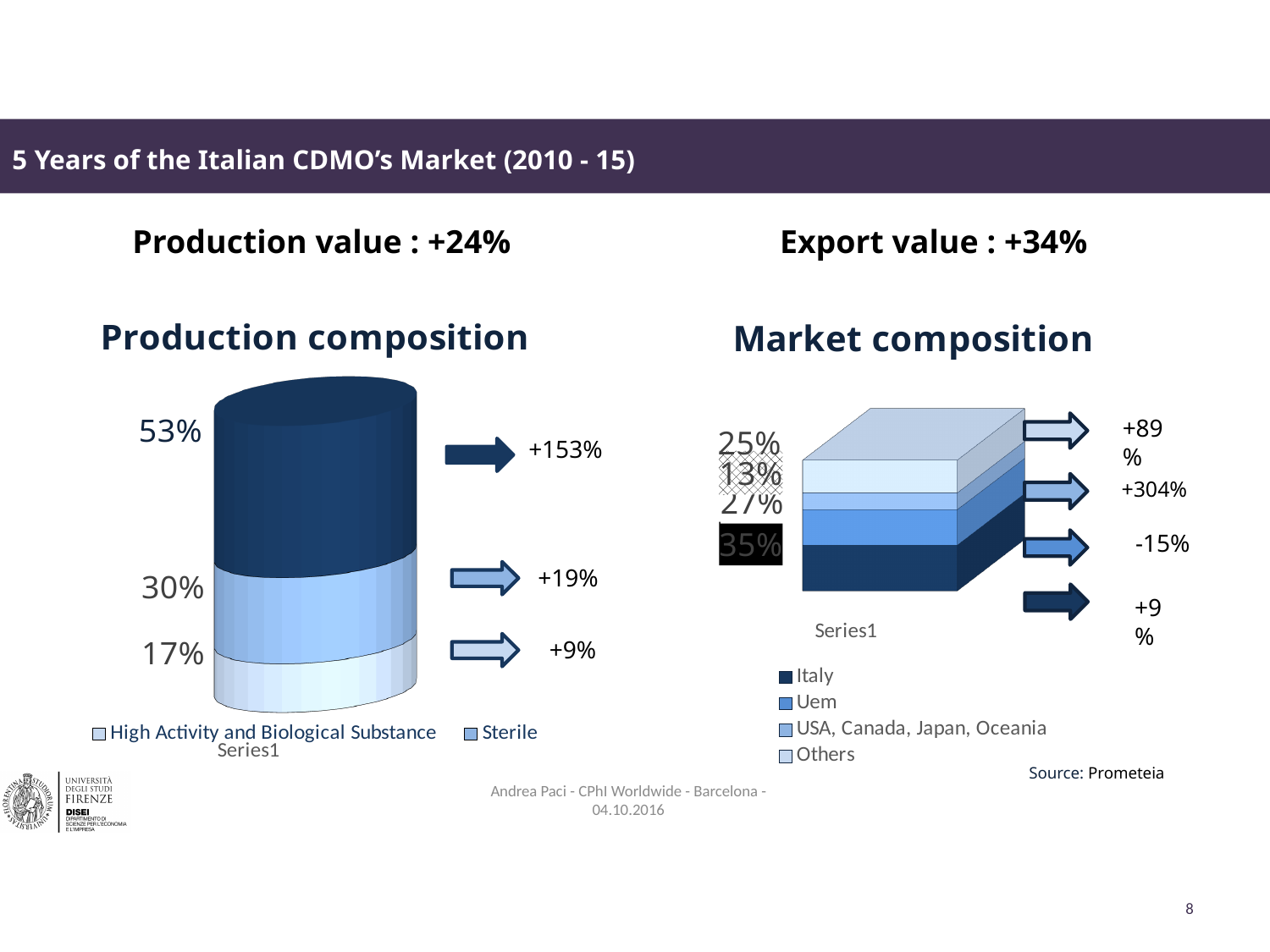
In the Market composition chart, what is the value for Italy? 35% In the Market composition chart, what is the value for Others? 25% How many entries does the legend of the Market composition chart list? 4 What kind of chart is the Production composition chart? Stacked bar chart In the Production composition chart, what is the value of the Sterile segment? 30% In the Production composition chart, what is the smallest segment value? 17% In the Market composition chart, which category has the largest share? Italy In the Market composition chart, what is the total of the four stacked segments? 100% In the Production composition chart, what is the total of the three stacked segments? 100% In the Market composition chart, which is larger, Italy or Others? Italy In the Production composition chart, what is the difference between the 53% segment and the 30% segment? 23 percentage points In the Production composition chart, what is the largest segment value? 53%